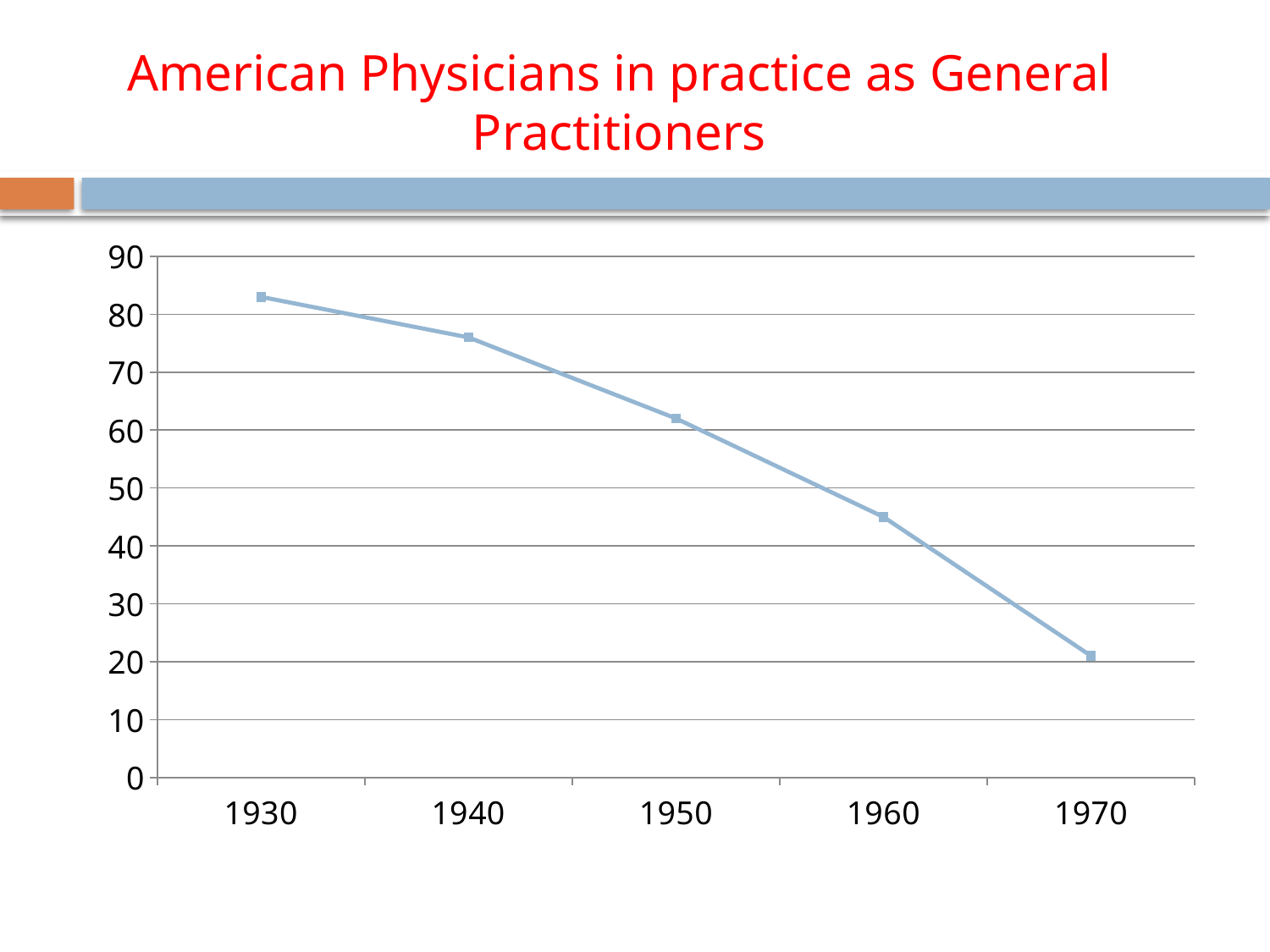
Which year has the lowest value? 1970 Is the value for 1960 greater or less than 50? less Is the value for 1930 greater or less than 80? greater What is the title of the slide containing the chart? American Physicians in practice as General Practitioners How many data points are plotted on the line? 5 Is the value for 1970 greater or less than 30? less Which is larger, the value for 1950 or the value for 1960? 1950 What kind of chart is shown on the slide? line chart Do the values rise or fall from 1930 to 1970? fall Which year has the highest value? 1930